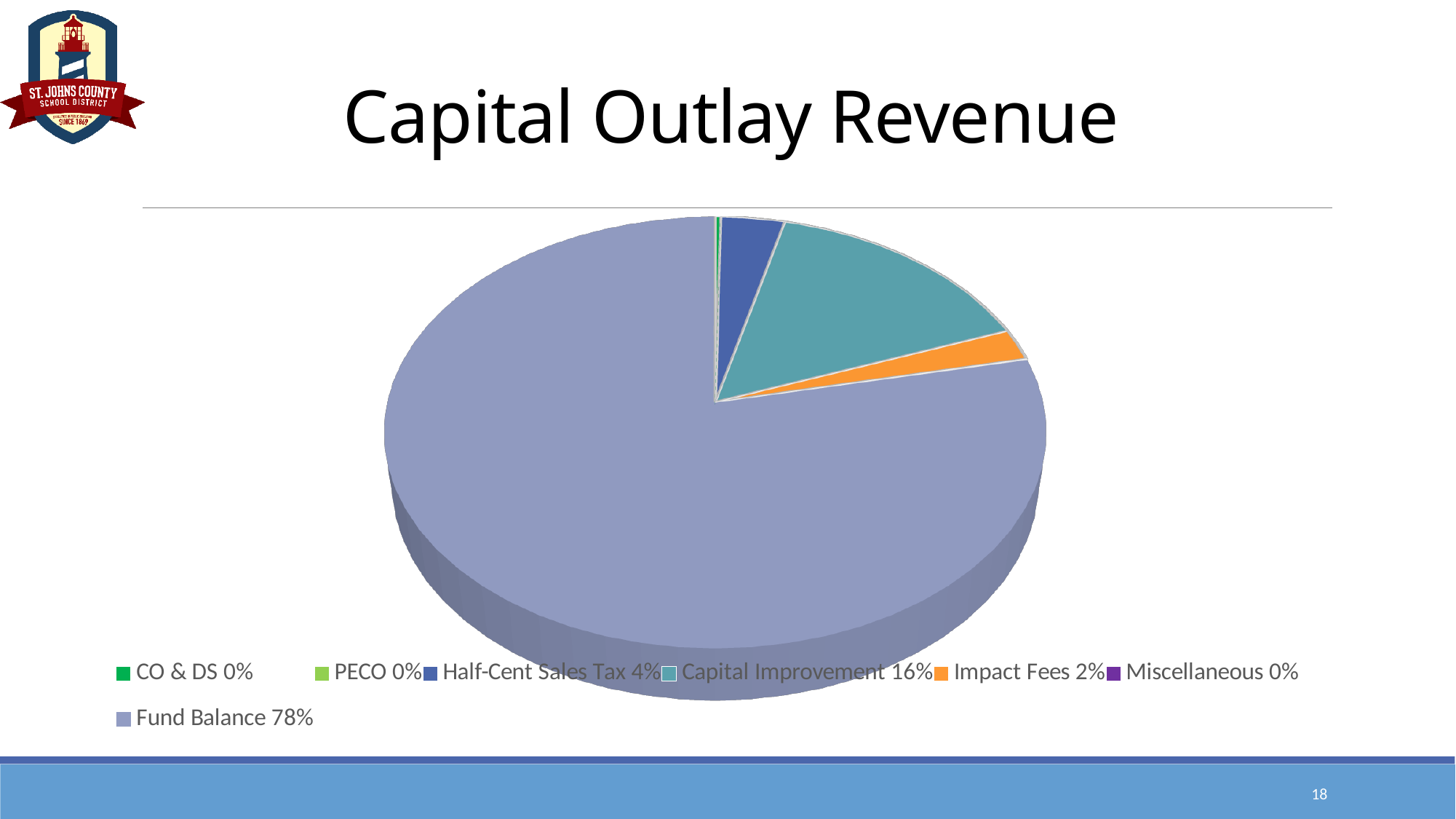
What share of Capital Outlay Revenue is Fund Balance? 78% What percentage is shown for PECO? 0% Which is larger, Half-Cent Sales Tax or Impact Fees? Half-Cent Sales Tax How many categories does the legend list? 7 What percentage is shown for Impact Fees? 2% What percentage is shown for Capital Improvement? 16% What colour is the Impact Fees slice? Orange What type of chart is shown on the slide? Pie chart Which category has the largest share of the pie? Fund Balance What percentage is shown for Half-Cent Sales Tax? 4% What is the title of the chart? Capital Outlay Revenue What is the difference in percentage points between Fund Balance and Capital Improvement? 62